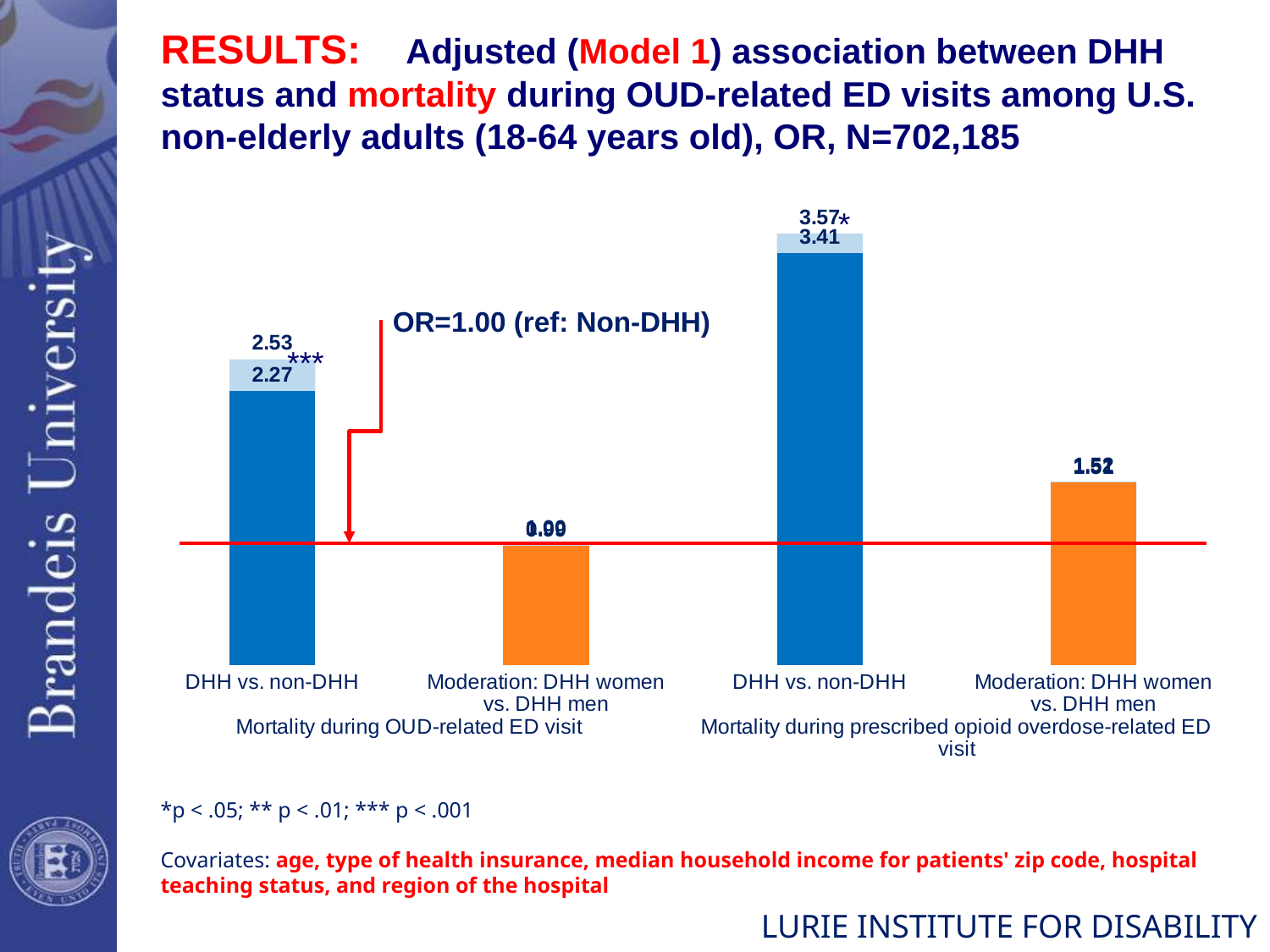
What is the lower value label printed on the 'DHH vs. non-DHH' bar for mortality during prescribed opioid overdose-related ED visit? 3.41 Which is larger: the moderation value for OUD-related ED visit mortality or the moderation value for prescribed opioid overdose-related ED visit mortality? prescribed opioid overdose-related ED visit (1.52) How many bars are plotted in the chart? 4 What does the red horizontal reference line in the chart represent, according to its label? OR=1.00 (ref: Non-DHH) What kind of chart is shown on the slide? bar chart What is the value labelled on the 'Moderation: DHH women vs. DHH men' bar for mortality during prescribed opioid overdose-related ED visit? 1.52 Which bar is the tallest in the chart? DHH vs. non-DHH (mortality during prescribed opioid overdose-related ED visit) What is the difference between the two 'Moderation: DHH women vs. DHH men' values (1.52 and 0.99)? 0.53 Is the 'Moderation: DHH women vs. DHH men' value for prescribed opioid overdose-related ED visit mortality greater or less than the OR=1.00 reference line? greater Which bar is the shortest in the chart? Moderation: DHH women vs. DHH men (mortality during OUD-related ED visit) What is the value labelled on the 'Moderation: DHH women vs. DHH men' bar for mortality during OUD-related ED visit? 0.99 What is the topmost value label printed above the 'DHH vs. non-DHH' bar for mortality during OUD-related ED visit? 2.53